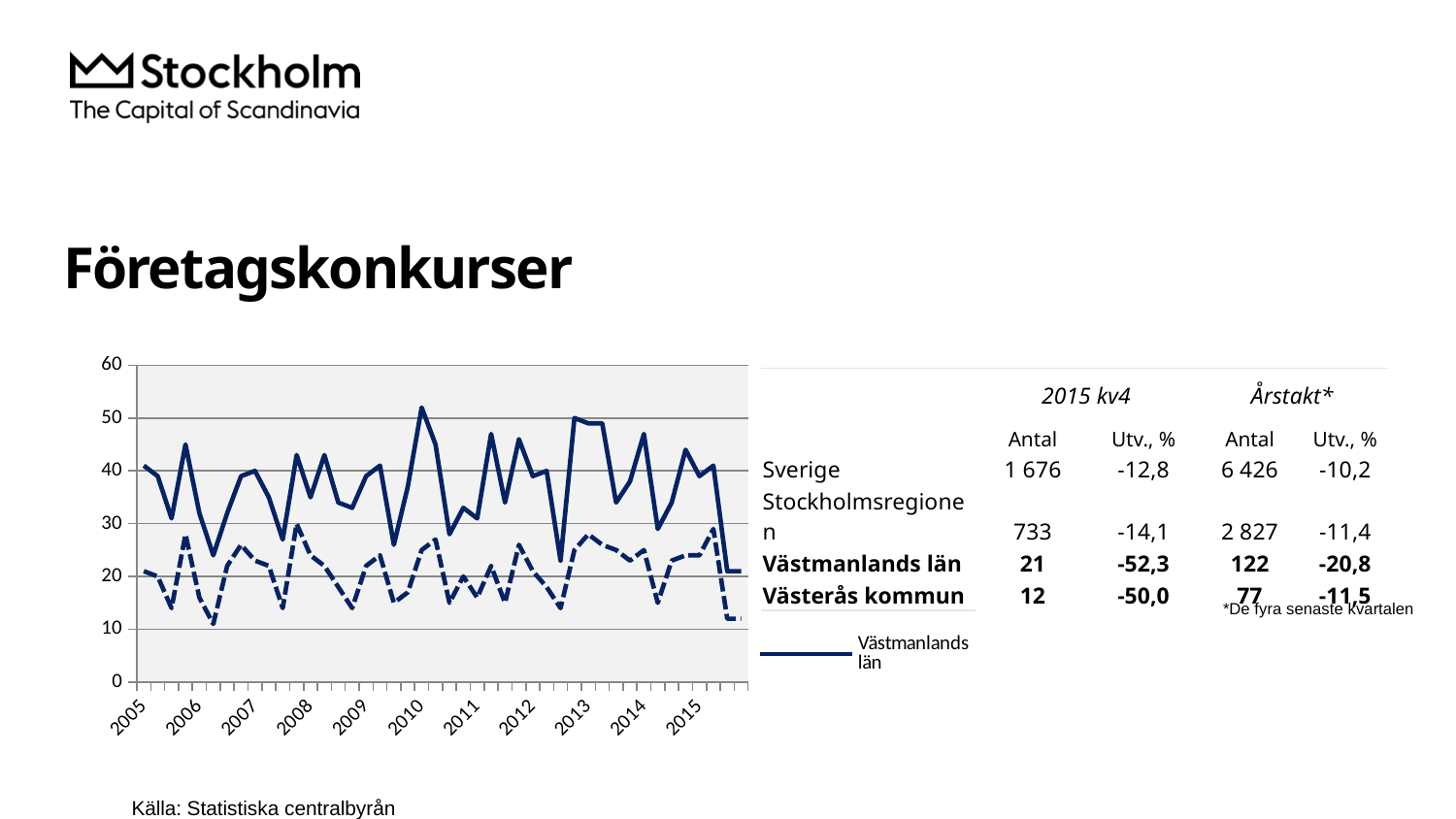
What is the highest value shown on the chart's vertical axis? 60 How many year labels are shown on the chart's horizontal axis? 11 How many lines are plotted in the chart? 2 Is the peak value of the solid line (Västmanlands län) greater or less than 50? greater Which line is higher across the whole period, the solid line or the dashed line? the solid line What is the last year labelled on the chart's horizontal axis? 2015 Does the solid line rise or fall at the very end of the series, after 2015? fall Which series name is shown in the chart legend? Västmanlands län Is the lowest value of the dashed line greater or less than 20? less What kind of chart is shown on the slide? line chart What is the title of the slide containing the chart? Företagskonkurser What is the first year labelled on the chart's horizontal axis? 2005